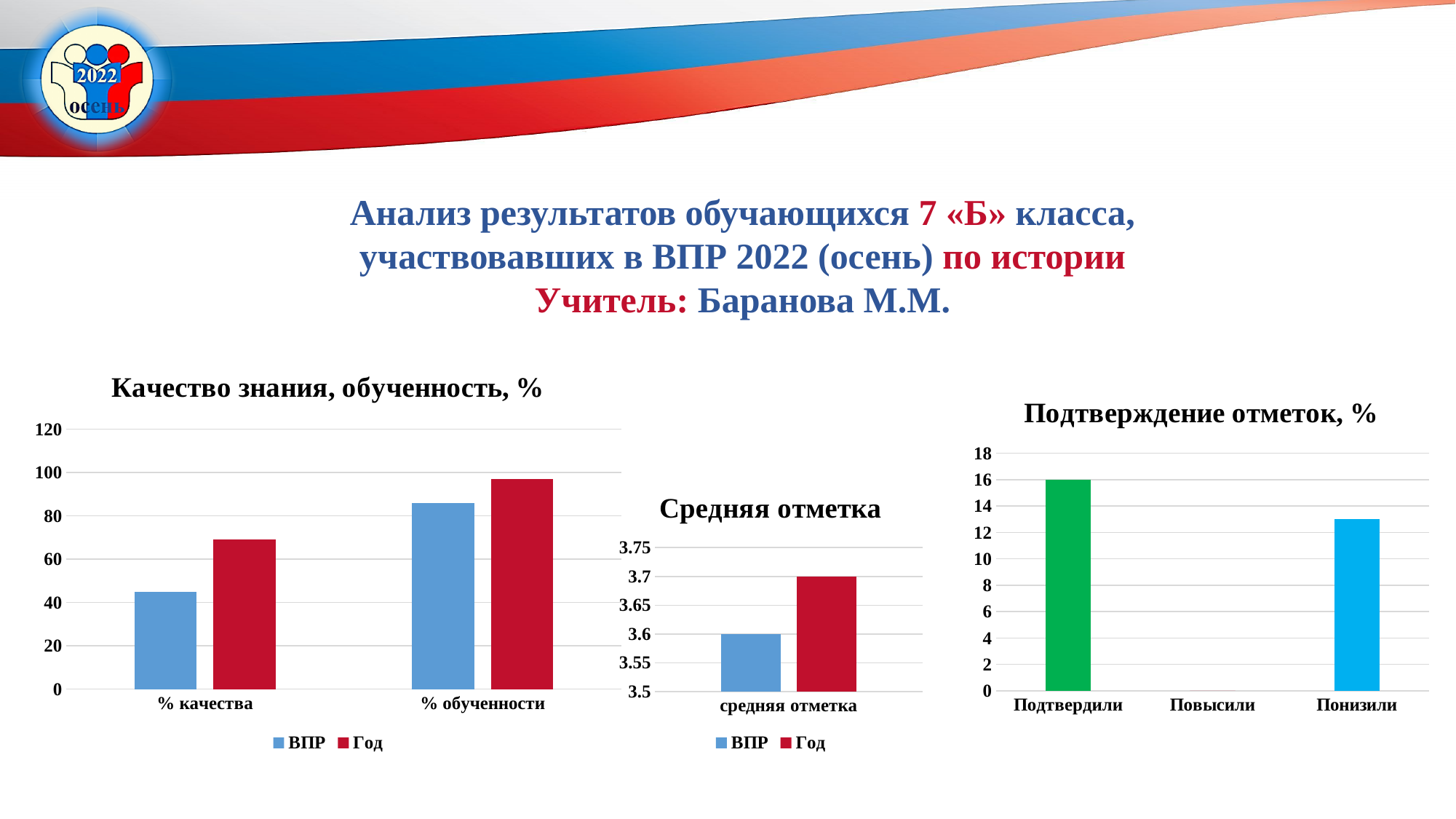
In the chart titled "Подтверждение отметок, %", what is the value for Подтвердили? 16 In the chart titled "Качество знания, обученность, %", which series has the larger value for % качества, ВПР or Год? Год In the chart titled "Подтверждение отметок, %", which category has the lowest value? Повысили In the chart titled "Качество знания, обученность, %", is the ВПР value for % качества greater or less than 40? greater In the chart titled "Средняя отметка", which series has the larger value, ВПР or Год? Год In the chart titled "Средняя отметка", what is the value for Год? 3.7 How many series does the legend of the chart titled "Качество знания, обученность, %" list? 2 In the chart titled "Качество знания, обученность, %", is the Год value for % обученности greater or less than 100? less In the chart titled "Подтверждение отметок, %", is the value for Понизили greater or less than 12? greater In the chart titled "Средняя отметка", what is the value for ВПР? 3.6 In the chart titled "Подтверждение отметок, %", which category has the highest value? Подтвердили In the chart titled "Подтверждение отметок, %", how many categories are shown on the x axis? 3